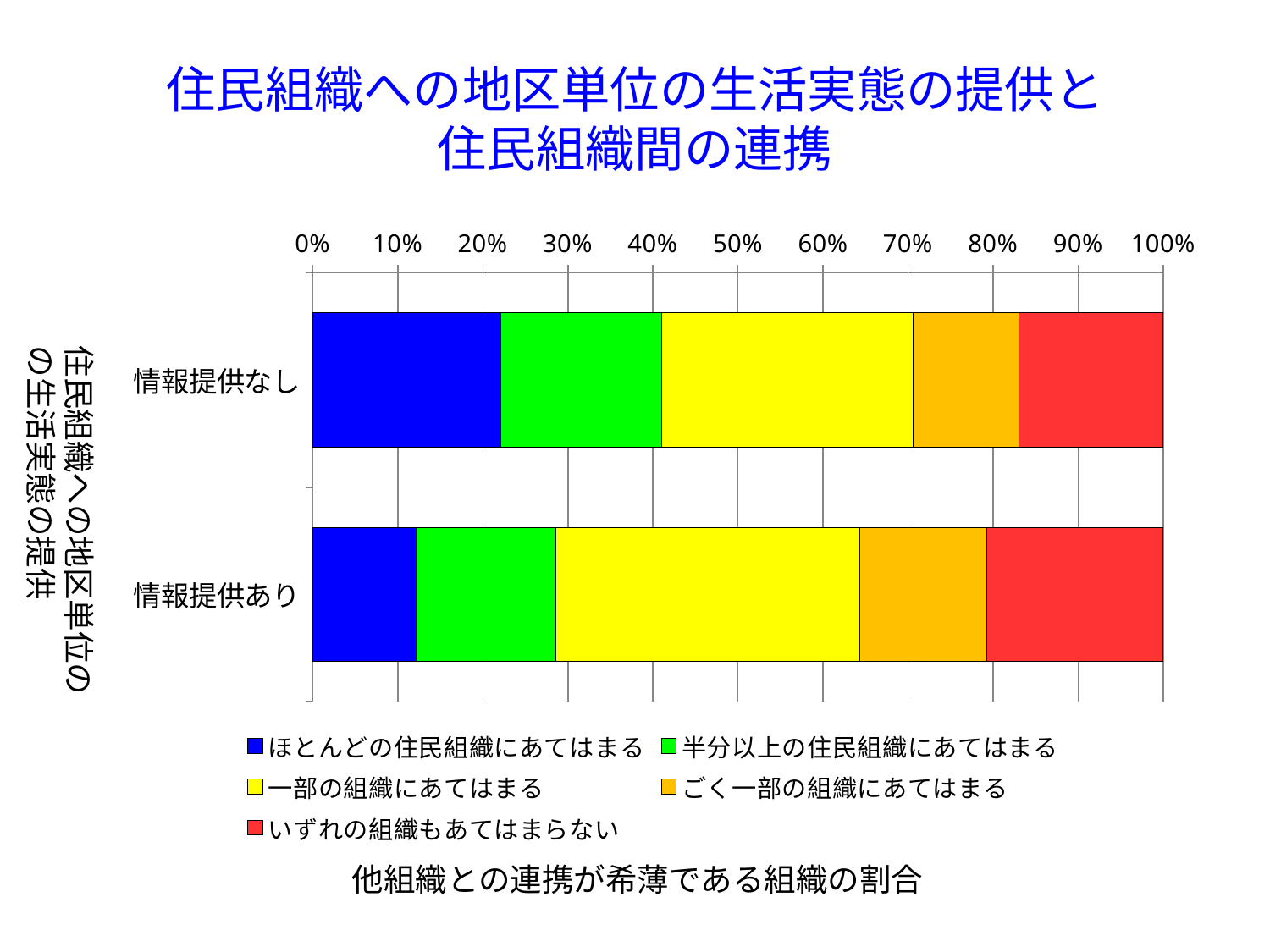
What is the title of the chart? 住民組織への地区単位の生活実態の提供と住民組織間の連携 Is the value of 一部の組織にあてはまる for 情報提供あり greater or less than 30%? greater Is the value of ほとんどの住民組織にあてはまる for 情報提供あり greater or less than 20%? less Which category has the larger 一部の組織にあてはまる segment, 情報提供なし or 情報提供あり? 情報提供あり How many series does the legend list? 5 Which category has the larger ほとんどの住民組織にあてはまる segment, 情報提供なし or 情報提供あり? 情報提供なし What kind of chart is shown on the slide? Stacked bar chart How many categories are plotted on the vertical axis of the chart? 2 Is the value of ほとんどの住民組織にあてはまる for 情報提供なし greater or less than 30%? less What is the label shown below the legend along the horizontal axis? 他組織との連携が希薄である組織の割合 Which series has the largest segment in the 情報提供あり bar? 一部の組織にあてはまる